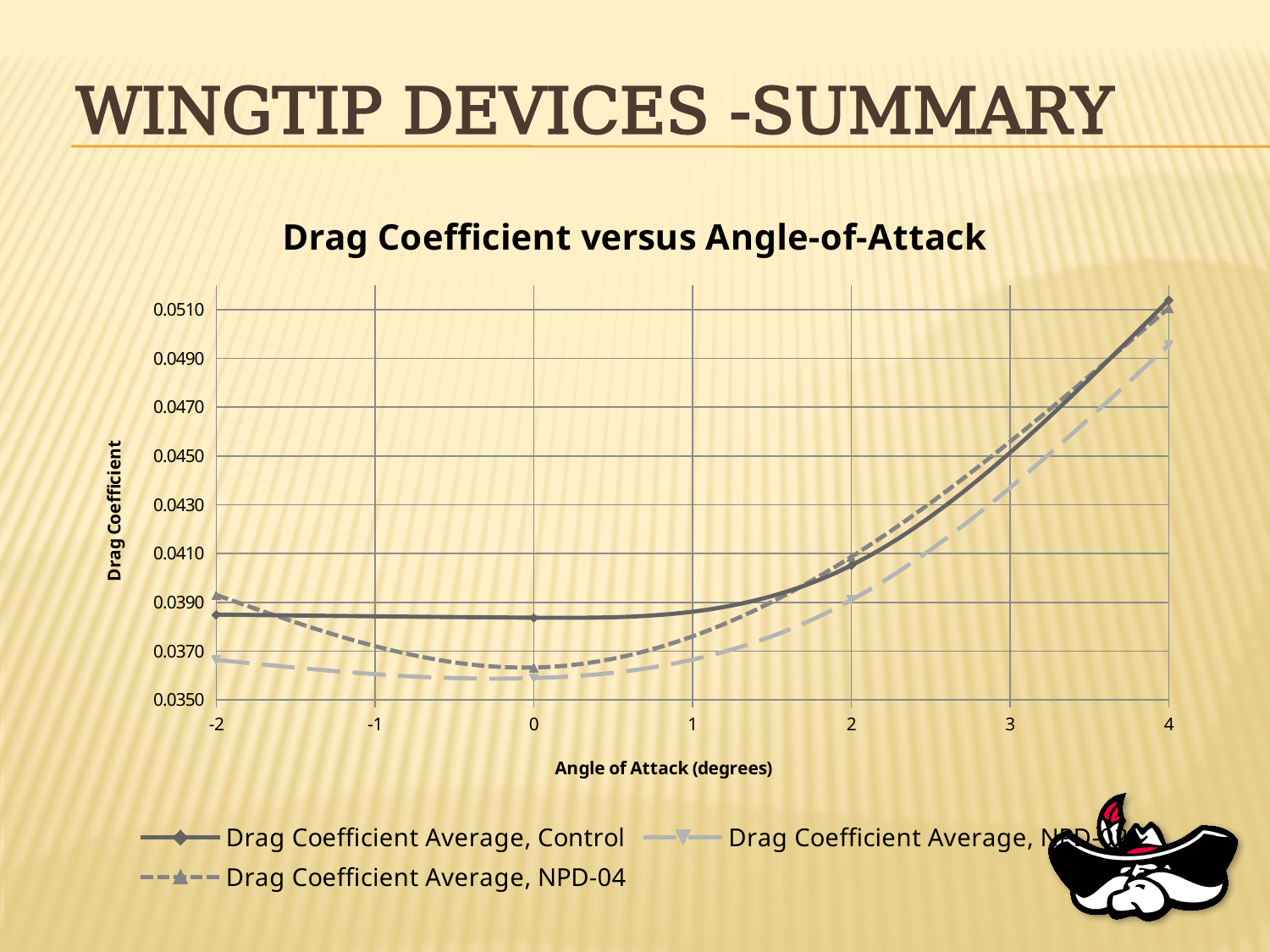
What is the label of the x axis? Angle of Attack (degrees) How many series does the legend list? 3 Is the value for Drag Coefficient Average, Control at an angle of attack of 3 degrees greater or less than 0.0430? greater Is the value for Drag Coefficient Average, Control at an angle of attack of 2 degrees greater or less than 0.0390? greater Which series has the highest drag coefficient at an angle of attack of -2 degrees? Drag Coefficient Average, NPD-04 Is the value for Drag Coefficient Average, NPD-04 at an angle of attack of -2 degrees greater or less than 0.0370? greater Does the Drag Coefficient Average, Control series rise or fall as the angle of attack increases from 1 to 4 degrees? rise At an angle of attack of 0 degrees, which is larger: Drag Coefficient Average, Control or Drag Coefficient Average, NPD-04? Drag Coefficient Average, Control What is the title of the chart? Drag Coefficient versus Angle-of-Attack How many angle-of-attack values are marked on the x axis? 7 What kind of chart is shown on the slide? line chart